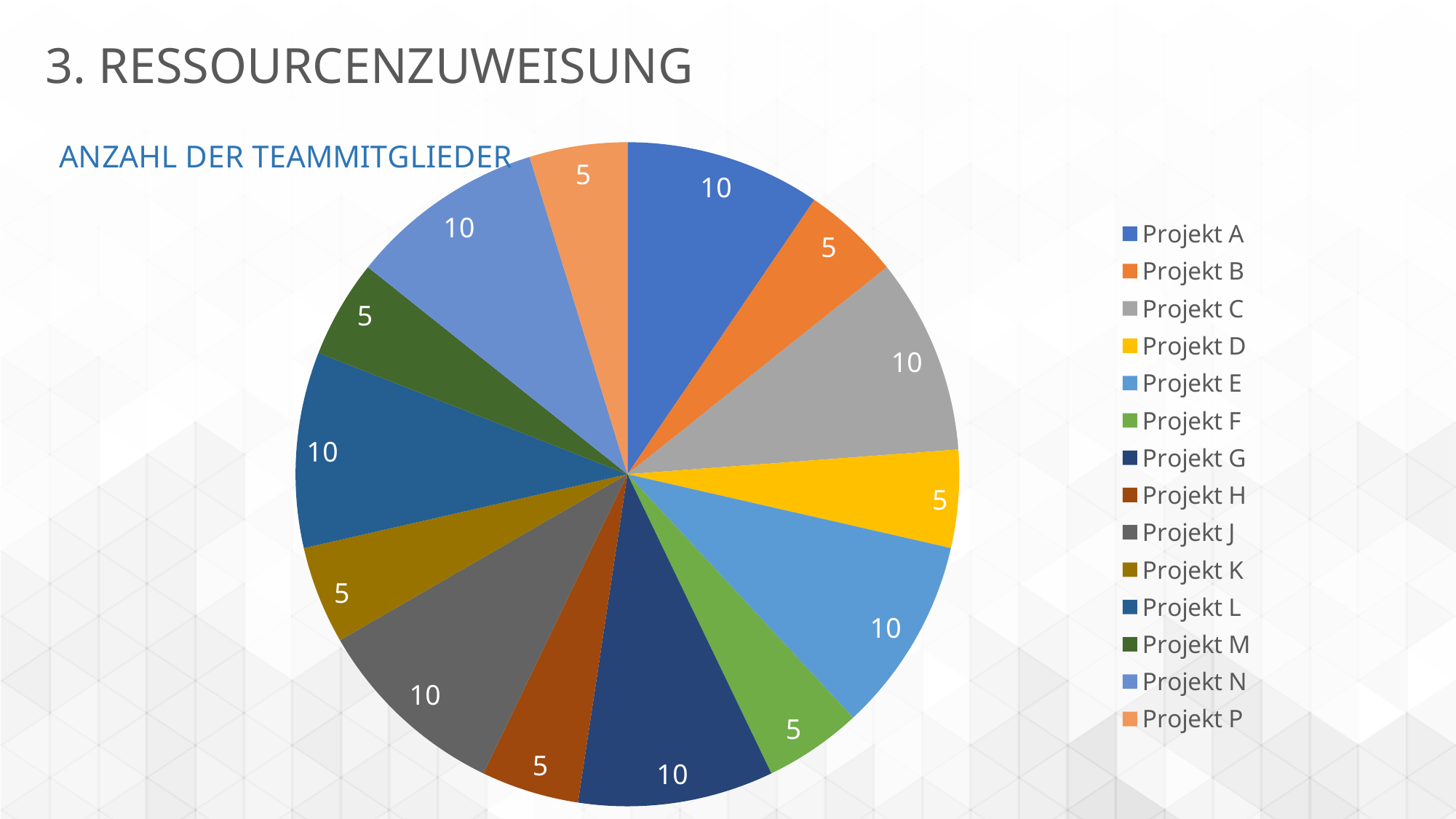
How many projects (slices) does the pie chart show? 14 Which has the larger value, Projekt H or Projekt J? Projekt J What is the difference between the values for Projekt A and Projekt B? 5 What is the value for Projekt D? 5 What is the title of the chart? ANZAHL DER TEAMMITGLIEDER What kind of chart is shown on the slide? pie chart What is the largest value shown on any slice of the pie chart? 10 Which has the larger value, Projekt C or Projekt D? Projekt C What is the value for Projekt L? 10 What is the value for Projekt B? 5 What is the total of all slice values in the pie chart? 105 What is the value for Projekt A? 10